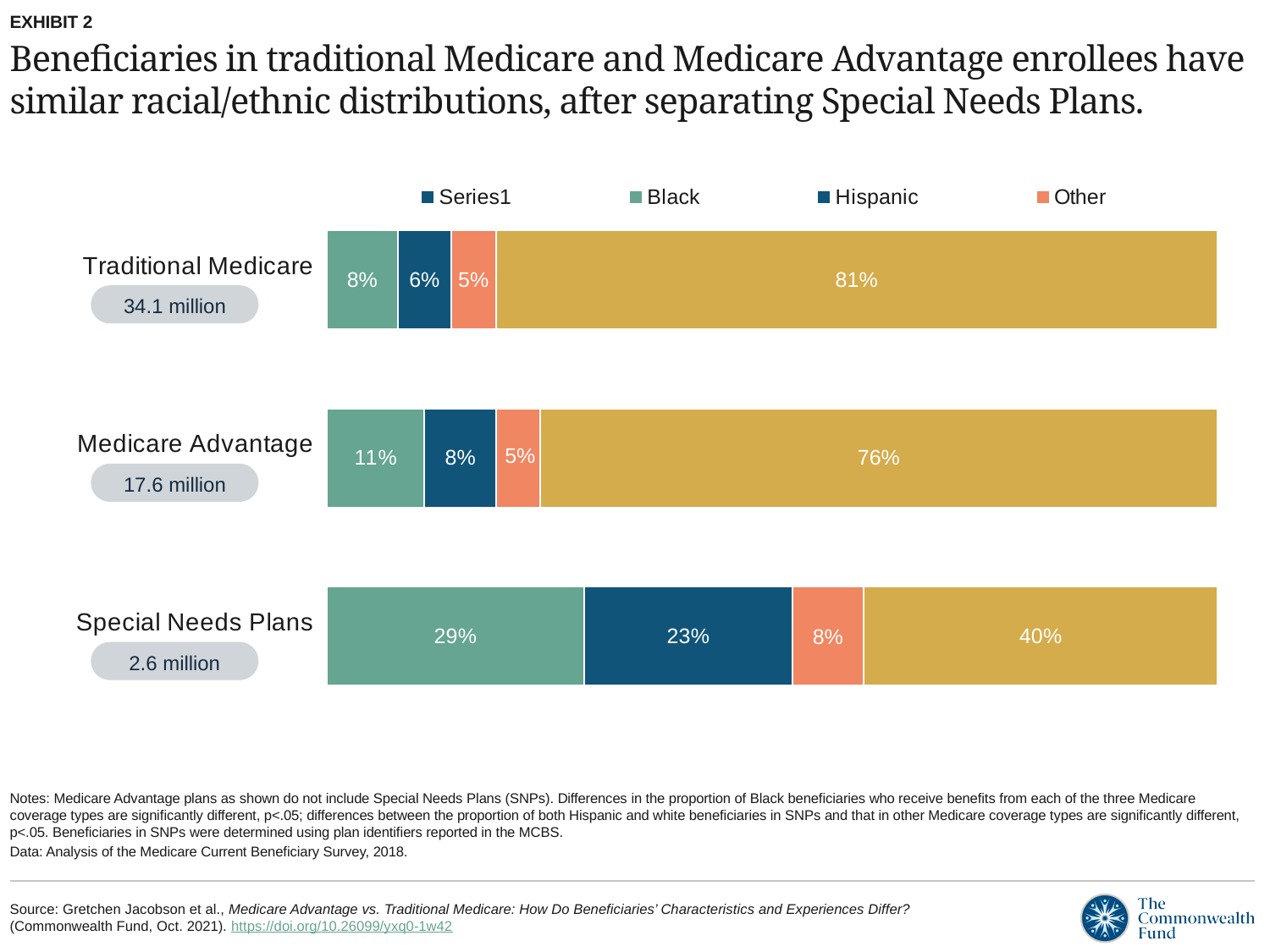
How many coverage types (bars) are shown in the chart? 3 What is the value of the gold segment in the Special Needs Plans bar? 40% What percentage of Special Needs Plans enrollees are Hispanic? 23% Which has a larger Hispanic share, Traditional Medicare or Medicare Advantage? Medicare Advantage What percentage of Traditional Medicare beneficiaries are Black? 8% Which coverage type has the highest share of Black beneficiaries? Special Needs Plans Which coverage type has the lowest share of Hispanic beneficiaries? Traditional Medicare What is the difference in percentage points between the Black share in Special Needs Plans and in Traditional Medicare? 21 percentage points What is the 'Other' share for Medicare Advantage? 5% What kind of chart is shown on the slide? Stacked bar chart How many series does the legend list? 4 What percentage of Medicare Advantage enrollees are Black? 11%